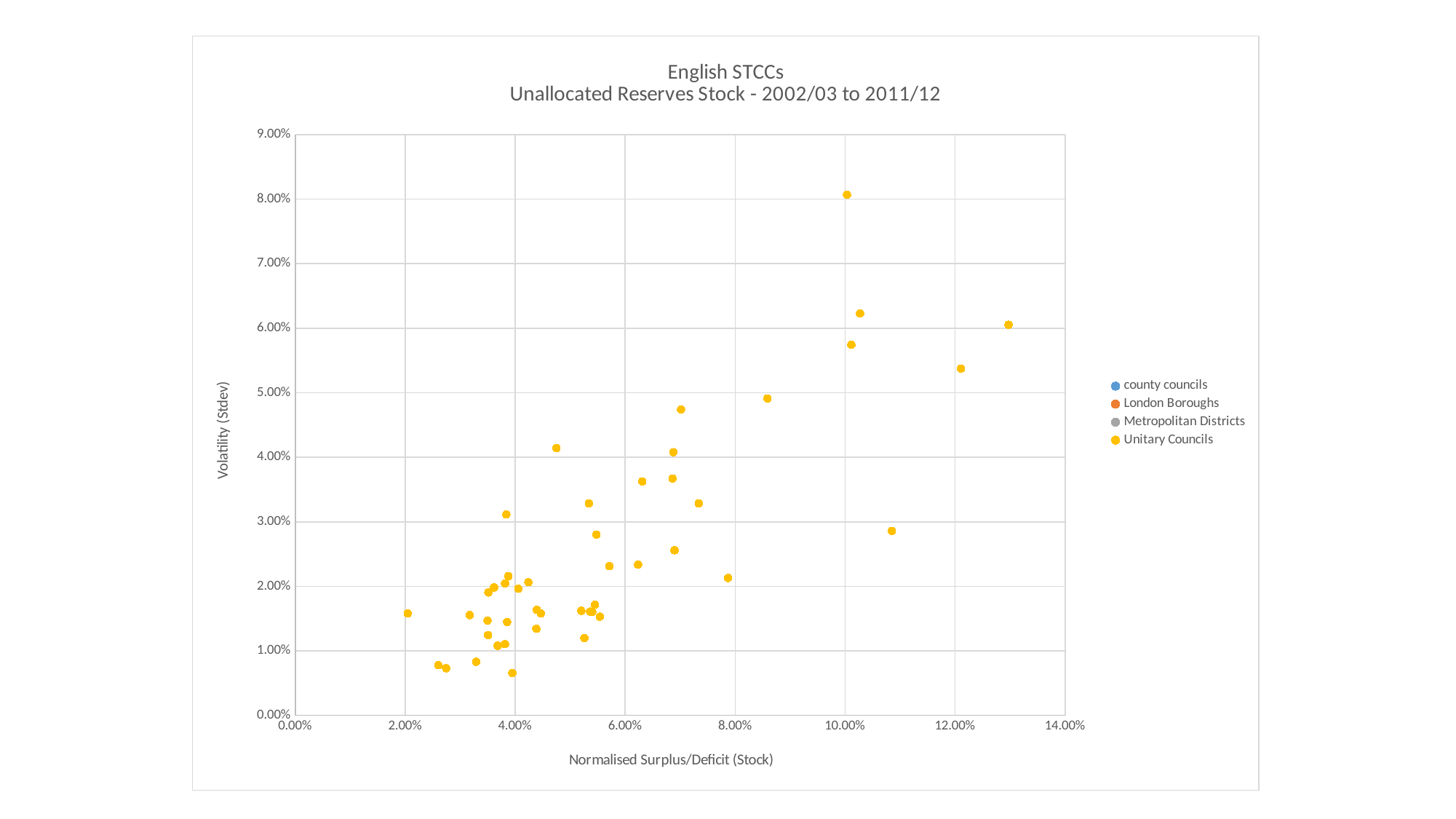
What is the title of the chart? English STCCs Unallocated Reserves Stock - 2002/03 to 2011/12 Is the normalised surplus/deficit of the leftmost plotted point greater or less than 4.00%? less What kind of chart is shown on the slide? Scatter chart Is the volatility of the point at roughly 10.00% normalised surplus/deficit that sits highest on the chart greater or less than 6.00%? greater How many series does the legend list? 4 Which series do the visible plotted points belong to, according to the legend colour? Unitary Councils Do the volatility values generally rise or fall as the normalised surplus/deficit increases along the x axis? Rise Is the volatility of the highest plotted point greater or less than 7.00%? greater What is the maximum value shown on the vertical axis? 9.00% What is the label of the horizontal axis? Normalised Surplus/Deficit (Stock)